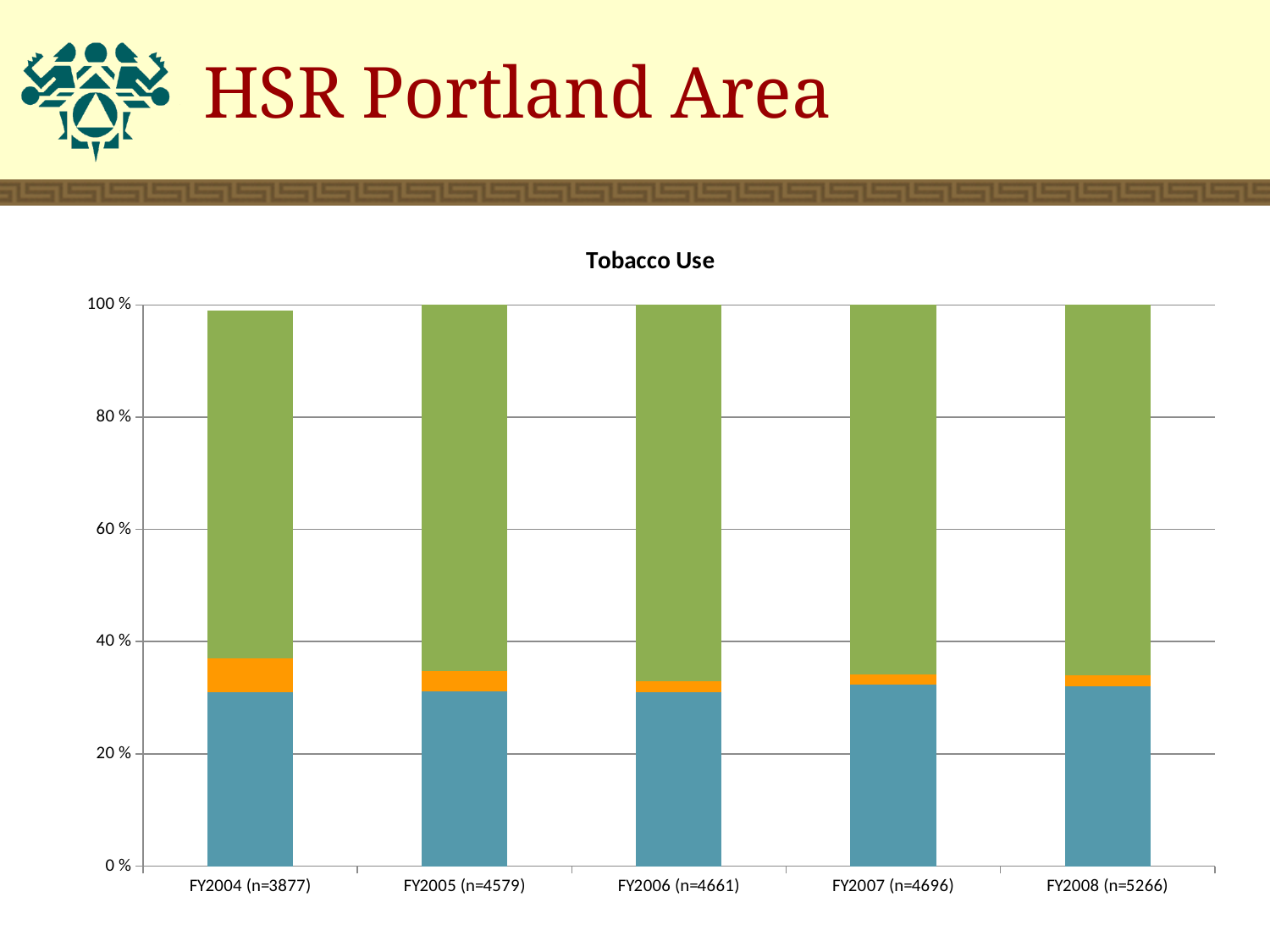
Is the value of the blue (bottom) segment for FY2004 (n=3877) greater or less than 40%? less Is the orange segment larger for FY2004 (n=3877) or for FY2006 (n=4661)? FY2004 (n=3877) Is the top of the green segment for FY2006 (n=4661) greater or less than 80%? greater What type of chart is shown on the slide? stacked bar chart Which fiscal year has the largest orange (middle) segment? FY2004 (n=3877) What is the title of the chart? Tobacco Use How many fiscal years (bars) are shown on the x axis? 5 Is the value of the blue (bottom) segment for FY2007 (n=4696) greater or less than 20%? greater What sample size (n) is given in the x-axis label for FY2008? n=5266 What is the highest value shown on the y axis? 100 % How many coloured segments make up each stacked bar? 3